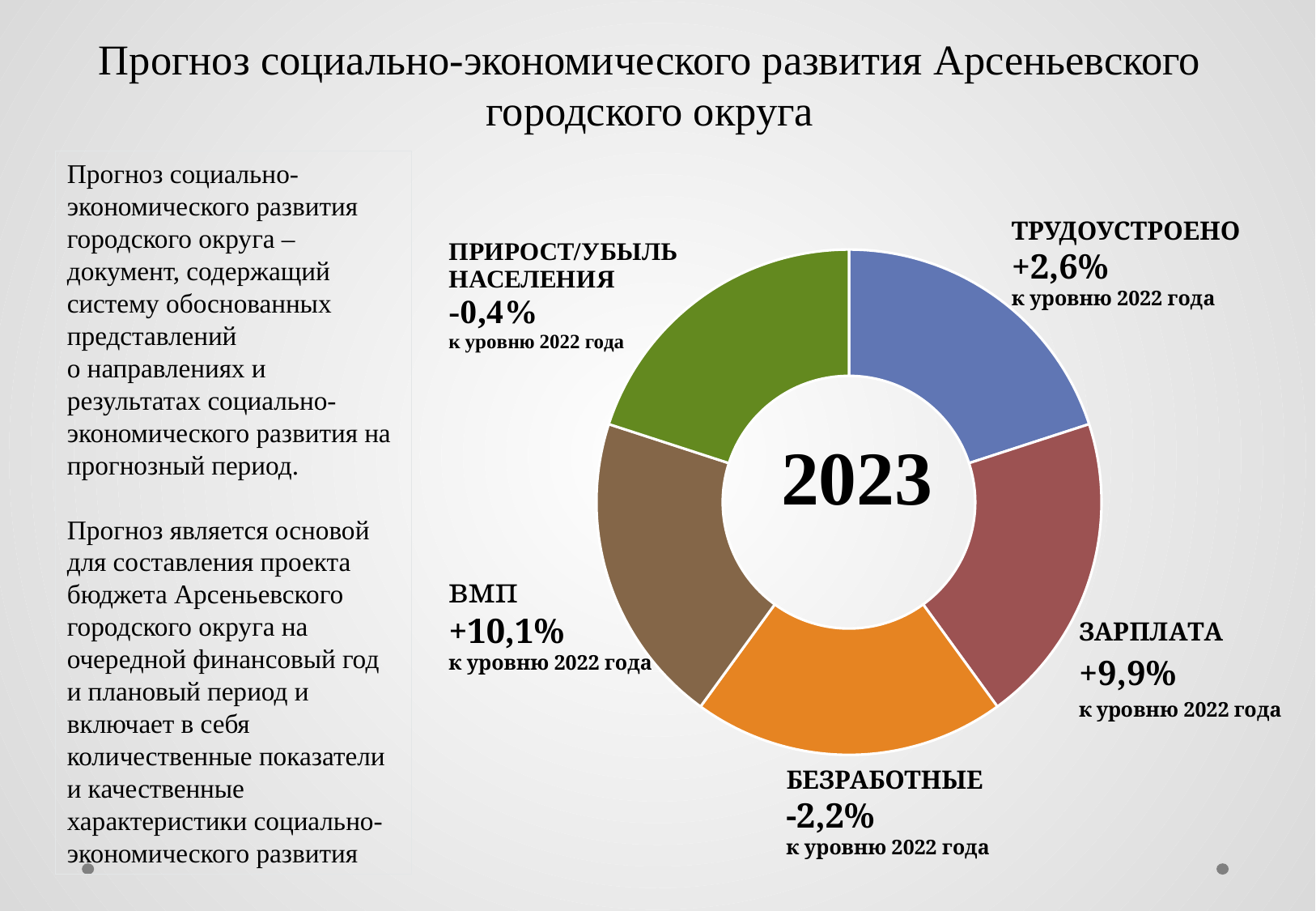
What value is shown for ЗАРПЛАТА on the chart? +9,9% Which is larger, the value for ЗАРПЛАТА or the value for ТРУДОУСТРОЕНО? ЗАРПЛАТА What year is printed in the centre of the chart? 2023 What value is shown for ТРУДОУСТРОЕНО on the chart? +2,6% What value is shown for ВМП on the chart? +10,1% How many segments does the chart have? 5 Which indicator on the chart has the highest value? ВМП What value is shown for ПРИРОСТ/УБЫЛЬ НАСЕЛЕНИЯ on the chart? -0,4% What is the difference between the value for ВМП and the value for ЗАРПЛАТА? 0,2% What value is shown for БЕЗРАБОТНЫЕ on the chart? -2,2% Which indicator on the chart has the lowest value? БЕЗРАБОТНЫЕ What kind of chart is shown on the slide? Donut (pie) chart